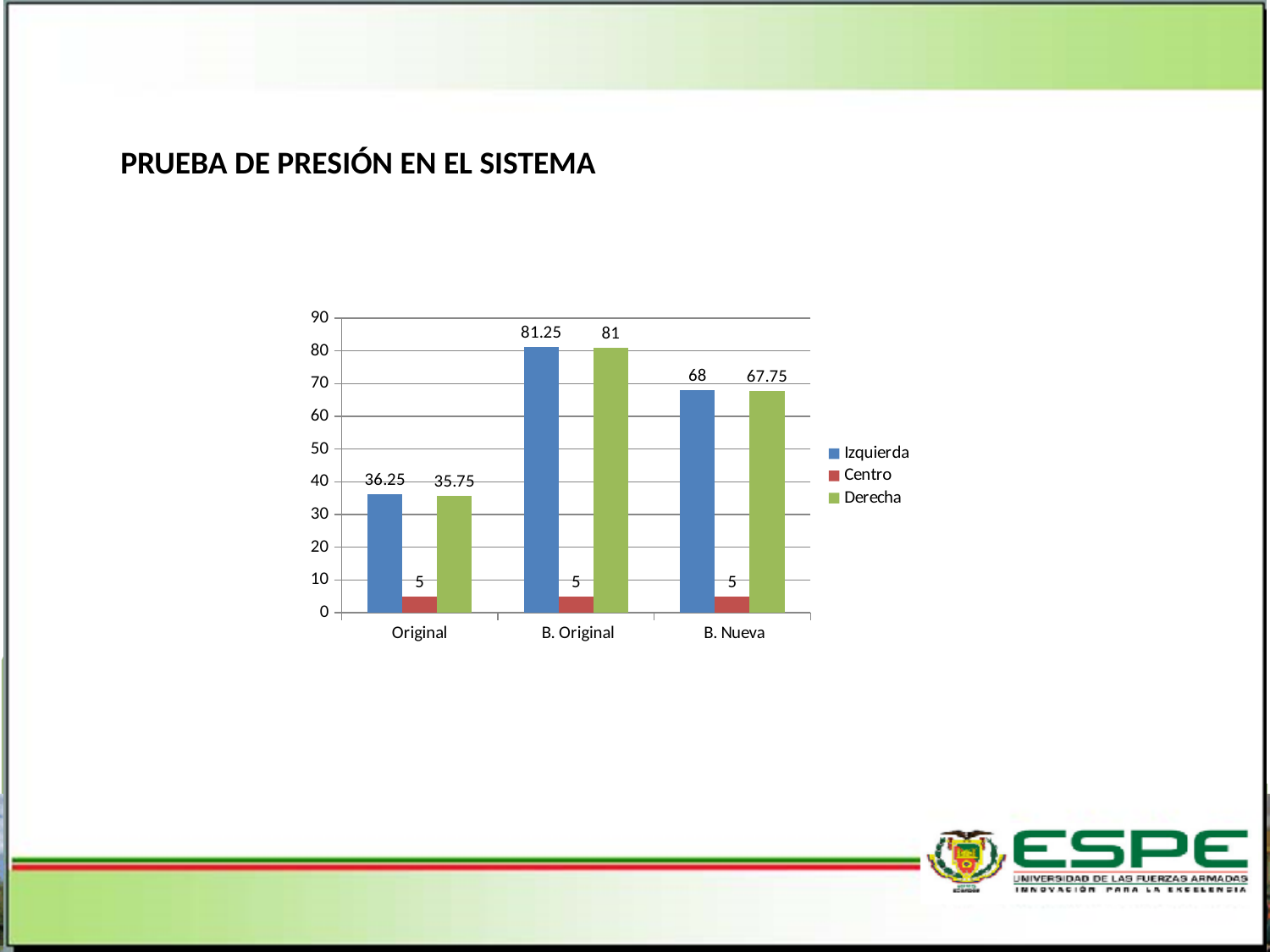
What is the value of Derecha for Original? 35.75 What is the value of Centro for Original? 5 How many series does the legend list? 3 Which is larger, the Izquierda value for Original or the Derecha value for B. Nueva? Derecha for B. Nueva What is the value of Derecha for B. Nueva? 67.75 Which category has the lowest Derecha value? Original How many categories are shown on the x axis? 3 What is the difference between the Izquierda values for B. Original and B. Nueva? 13.25 What is the value of Izquierda for B. Original? 81.25 Which category has the highest Izquierda value? B. Original What colour represents the Centro series? Red What kind of chart is shown on the slide? Bar chart